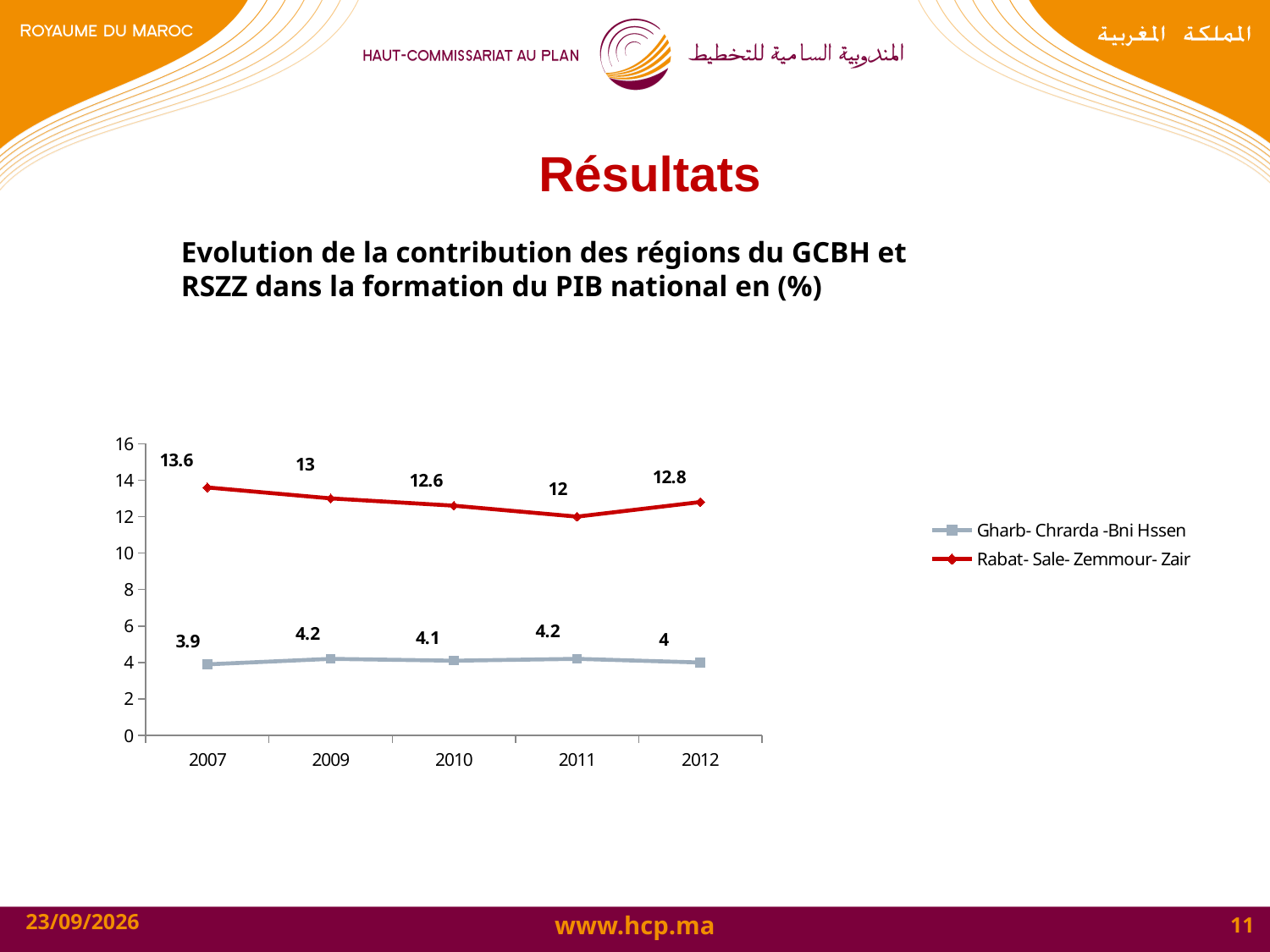
What is the value for Gharb- Chrarda -Bni Hssen in 2010? 4.1 In which year is the value for Rabat- Sale- Zemmour- Zair highest? 2007 What is the value for Rabat- Sale- Zemmour- Zair in 2007? 13.6 What kind of chart is shown on the slide? line chart What is the value for Rabat- Sale- Zemmour- Zair in 2012? 12.8 How many years are shown on the x axis? 5 Is the value for Gharb- Chrarda -Bni Hssen in 2012 greater or less than 6? less What is the difference between the Rabat- Sale- Zemmour- Zair values in 2007 and 2012? 0.8 How many series does the legend list? 2 What is the difference between the Rabat- Sale- Zemmour- Zair value and the Gharb- Chrarda -Bni Hssen value in 2011? 7.8 Which series has the larger value in 2009, Gharb- Chrarda -Bni Hssen or Rabat- Sale- Zemmour- Zair? Rabat- Sale- Zemmour- Zair In which year is the value for Rabat- Sale- Zemmour- Zair lowest? 2011